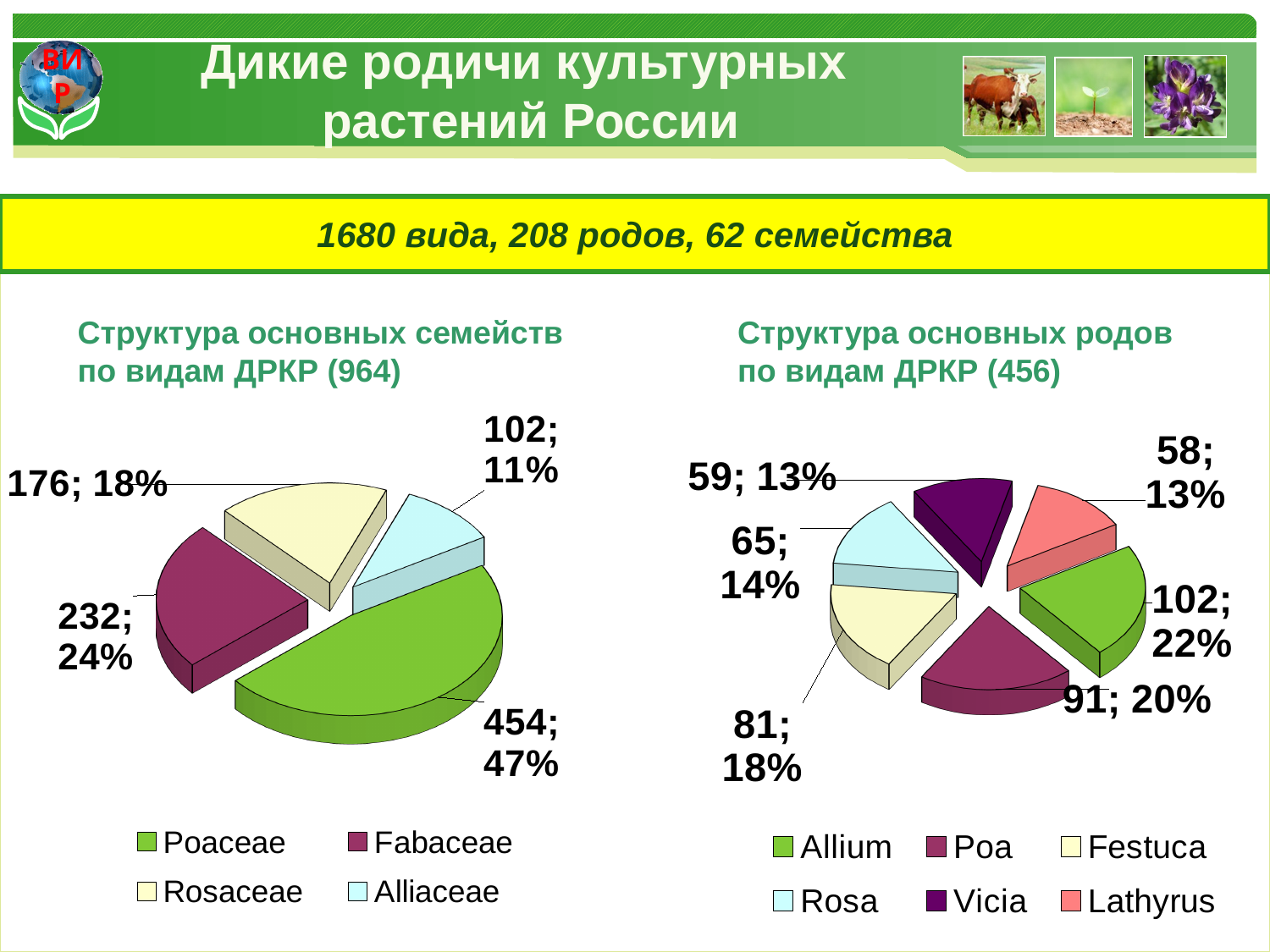
In the right chart (Структура основных родов по видам ДРКР), what is the value for Festuca? 81 In the left chart (Структура основных семейств по видам ДРКР), what is the difference between the Fabaceae and Rosaceae values? 56 In the left chart (Структура основных семейств по видам ДРКР), what share of the pie does Fabaceae have? 24% How many categories does the legend of the right chart (Структура основных родов по видам ДРКР) list? 6 How many categories does the legend of the left chart (Структура основных семейств по видам ДРКР) list? 4 In the left chart (Структура основных семейств по видам ДРКР), how many species does Poaceae account for? 454 In the right chart (Структура основных родов по видам ДРКР), which is larger, the value for Poa or the value for Vicia? Poa In the right chart (Структура основных родов по видам ДРКР), which genus has the largest slice? Allium In the left chart (Структура основных семейств по видам ДРКР), which family has the smallest slice? Alliaceae What kind of charts are shown on the slide? Pie charts In the right chart (Структура основных родов по видам ДРКР), what is the difference between the Allium and Lathyrus values? 44 In the right chart (Структура основных родов по видам ДРКР), what share of the pie does Rosa have? 14%